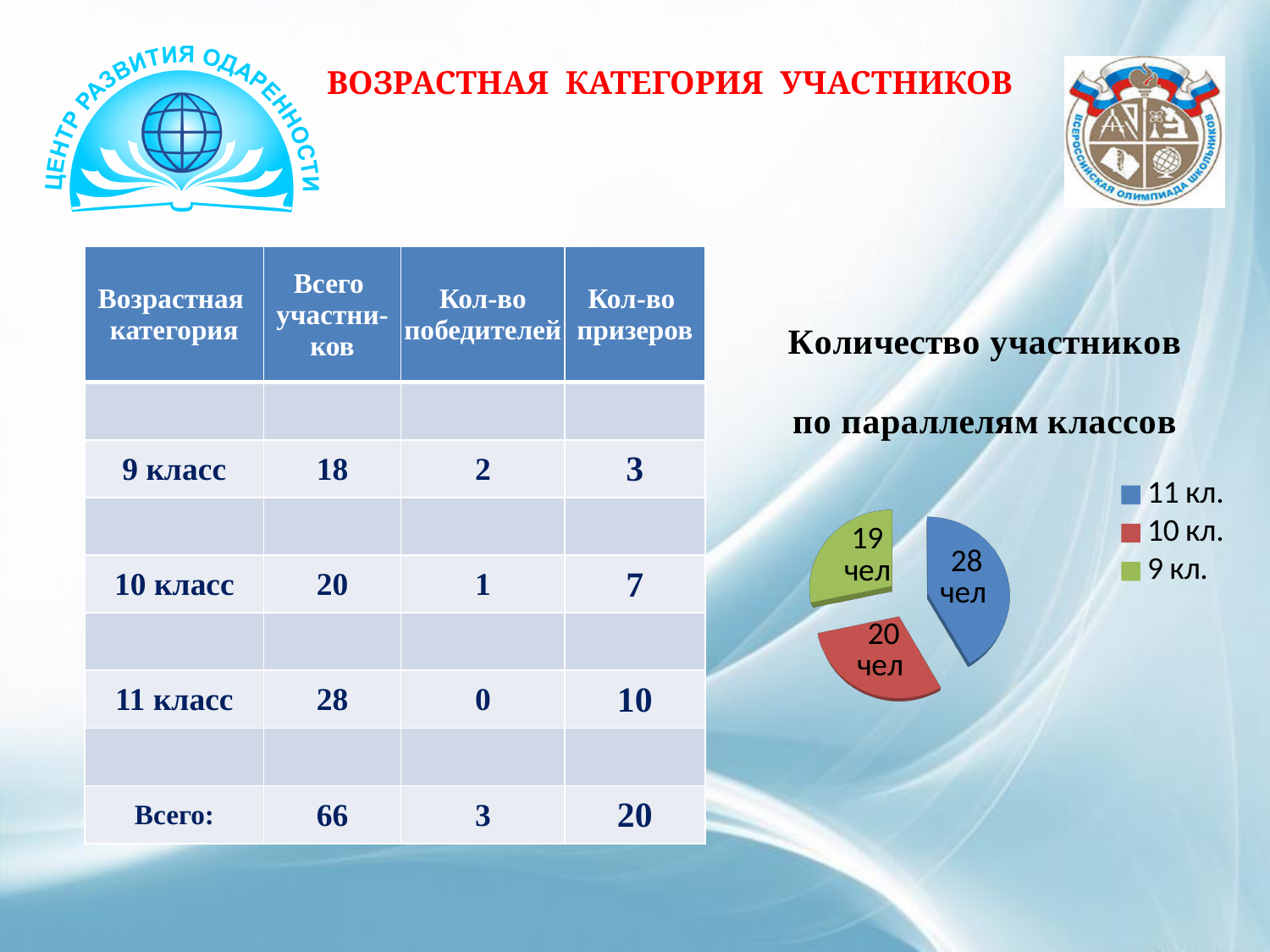
What kind of chart is shown on the slide? pie chart Which class has the largest slice in the pie chart? 11 кл. What is the title of the chart? Количество участников по параллелям классов How many entries does the chart legend list? 3 What value is shown on the pie slice for 11 кл.? 28 чел What value is shown on the pie slice for 10 кл.? 20 чел What colour is the 11 кл. slice in the pie chart? blue Which slice is larger in the pie chart, 10 кл. or 9 кл.? 10 кл. What value is shown on the pie slice for 9 кл.? 19 чел By how many people does the 11 кл. slice exceed the 10 кл. slice in the pie chart? 8 Which class has the smallest slice in the pie chart? 9 кл. How many slices does the pie chart have? 3